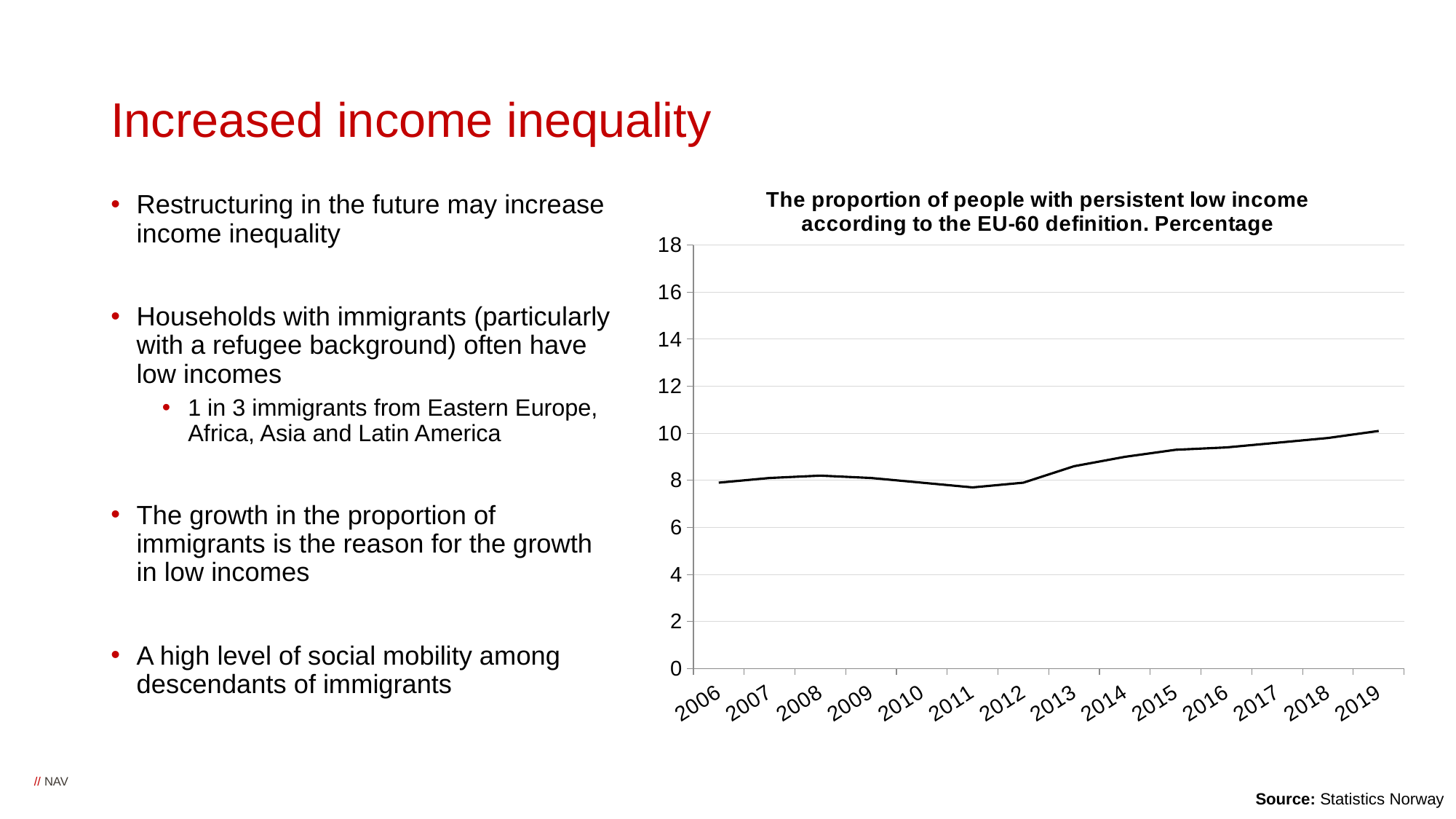
Is the value for 2006 greater or less than 10? less Which year has a higher value, 2011 or 2015? 2015 What kind of chart is shown on the slide? line chart What is the source of the data in the chart? Statistics Norway Is the value for 2011 greater or less than 8? less Does the proportion of people with persistent low income rise or fall between 2012 and 2019? rise Is the value for 2019 greater or less than 8? greater Which year has the highest proportion of people with persistent low income? 2019 How many years are plotted on the x axis of the chart? 14 Which year has a higher value, 2006 or 2019? 2019 Which year has the lowest proportion of people with persistent low income? 2011